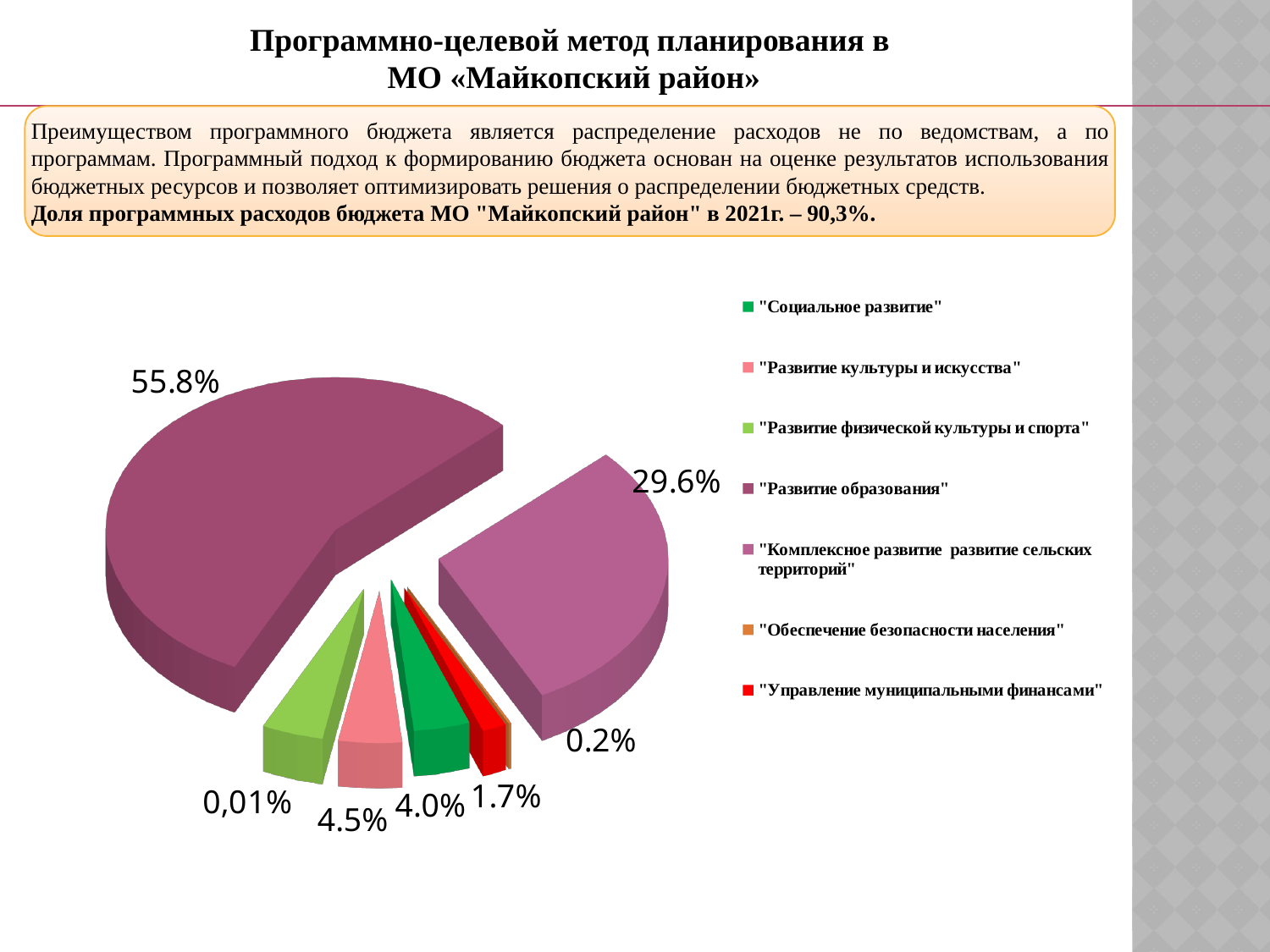
What is the largest percentage shown on the pie chart? 55.8% How many slices does the pie chart have? 7 What is the smallest percentage label shown on the pie chart? 0,01% Which legend entry is shown in red? "Управление муниципальными финансами" What share of the pie is labelled for "Развитие образования"? 55.8% What is the difference in percentage points between the 55.8% slice and the 29.6% slice? 26.2 Which legend entry is listed first in the chart legend? "Социальное развитие" What type of chart is shown on the slide? Pie chart Which slice is larger: "Развитие образования" or "Комплексное развитие сельских территорий"? "Развитие образования" What share of the pie is labelled for "Комплексное развитие сельских территорий"? 29.6% How many entries does the chart legend list? 7